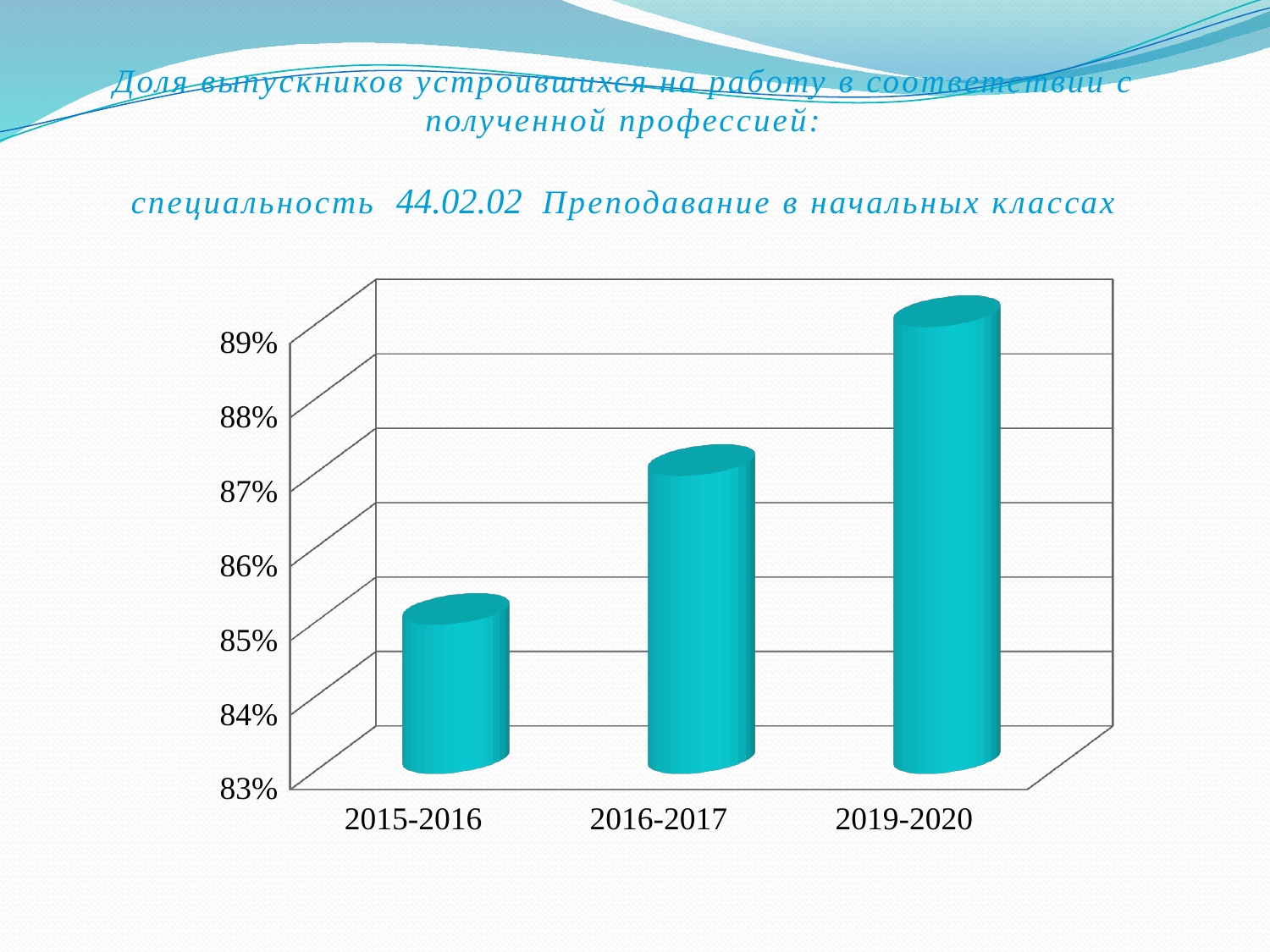
Is the value for 2019-2020 greater or less than 88%? greater Is the value for 2016-2017 greater or less than 86%? greater Do the values rise or fall from 2015-2016 to 2019-2020? rise Which specialty code is named in the chart's title? 44.02.02 How many categories (academic years) are shown on the x axis? 3 What kind of chart is shown on the slide? bar chart What is the lowest percentage shown on the vertical axis? 83% Which is larger, the value for 2019-2020 or the value for 2016-2017? 2019-2020 Which academic year has the lowest value? 2015-2016 Which academic year has the highest value? 2019-2020 Which is larger, the value for 2016-2017 or the value for 2015-2016? 2016-2017 Is the value for 2015-2016 greater or less than 86%? less